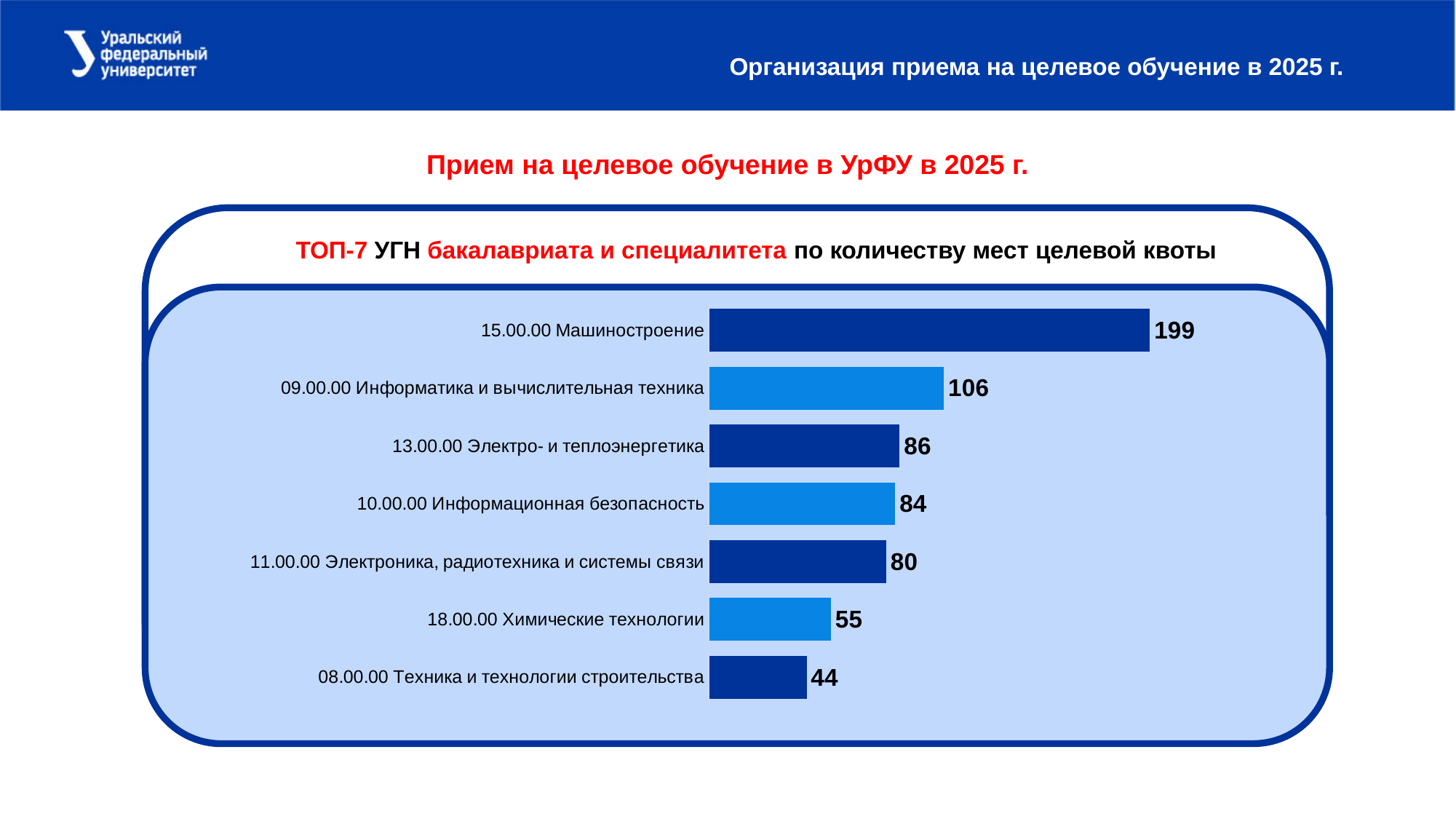
How many categories are shown in the chart? 7 Which is larger: the value for 11.00.00 Электроника, радиотехника и системы связи or the value for 18.00.00 Химические технологии? 11.00.00 Электроника, радиотехника и системы связи What is the value for 10.00.00 Информационная безопасность? 84 What is the difference between the values for 13.00.00 Электро- и теплоэнергетика and 08.00.00 Техника и технологии строительства? 42 What is the value for 15.00.00 Машиностроение? 199 What is the value for 09.00.00 Информатика и вычислительная техника? 106 What is the difference between the values for 15.00.00 Машиностроение and 09.00.00 Информатика и вычислительная техника? 93 Which category has the highest value? 15.00.00 Машиностроение Which category has the lowest value? 08.00.00 Техника и технологии строительства What kind of chart is shown on the slide? Bar chart What is the value for 18.00.00 Химические технологии? 55 What is the title of the chart? ТОП-7 УГН бакалавриата и специалитета по количеству мест целевой квоты